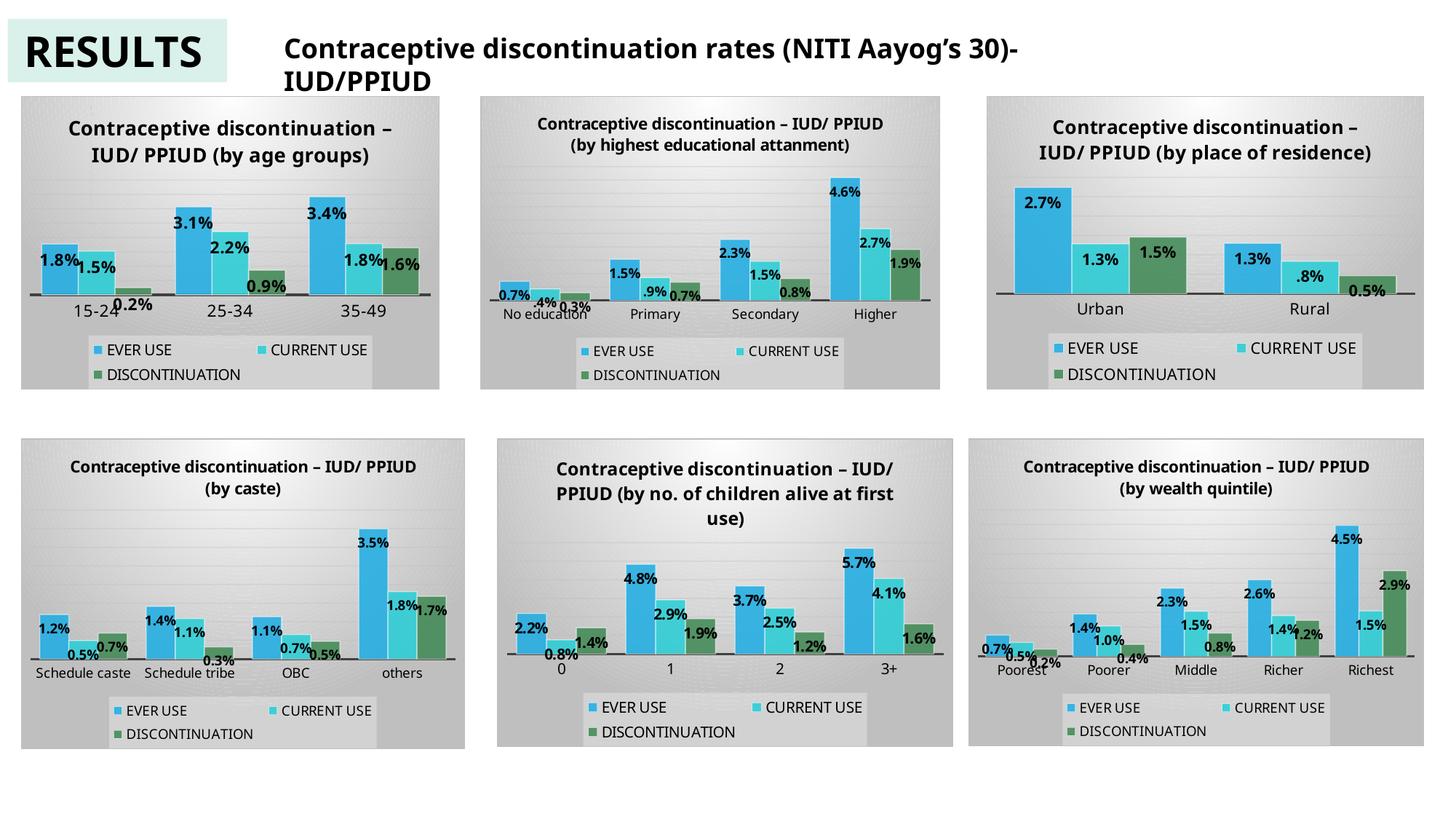
In the chart by no. of children alive at first use, what is the EVER USE value for 3+? 5.7% In the chart by caste, which caste category has the highest EVER USE value? others In the chart by wealth quintile, what is the DISCONTINUATION value for Richest? 2.9% In the chart by caste, how many caste categories are shown on the x axis? 4 How many series does the legend list in the chart by wealth quintile? 3 In the chart by age groups, what is the EVER USE value for the 35-49 age group? 3.4% In the chart by highest educational attainment, what is the difference between the EVER USE values for Higher and Secondary? 2.3% In the chart by highest educational attainment, what is the EVER USE value for Higher? 4.6% In the chart by place of residence, what is the CURRENT USE value for Rural? .8% In the chart by age groups, which age group has the lowest DISCONTINUATION value? 15-24 In the chart by place of residence, which is larger: the DISCONTINUATION value for Urban or for Rural? Urban In the chart by no. of children alive at first use, which category has the highest DISCONTINUATION value? 1